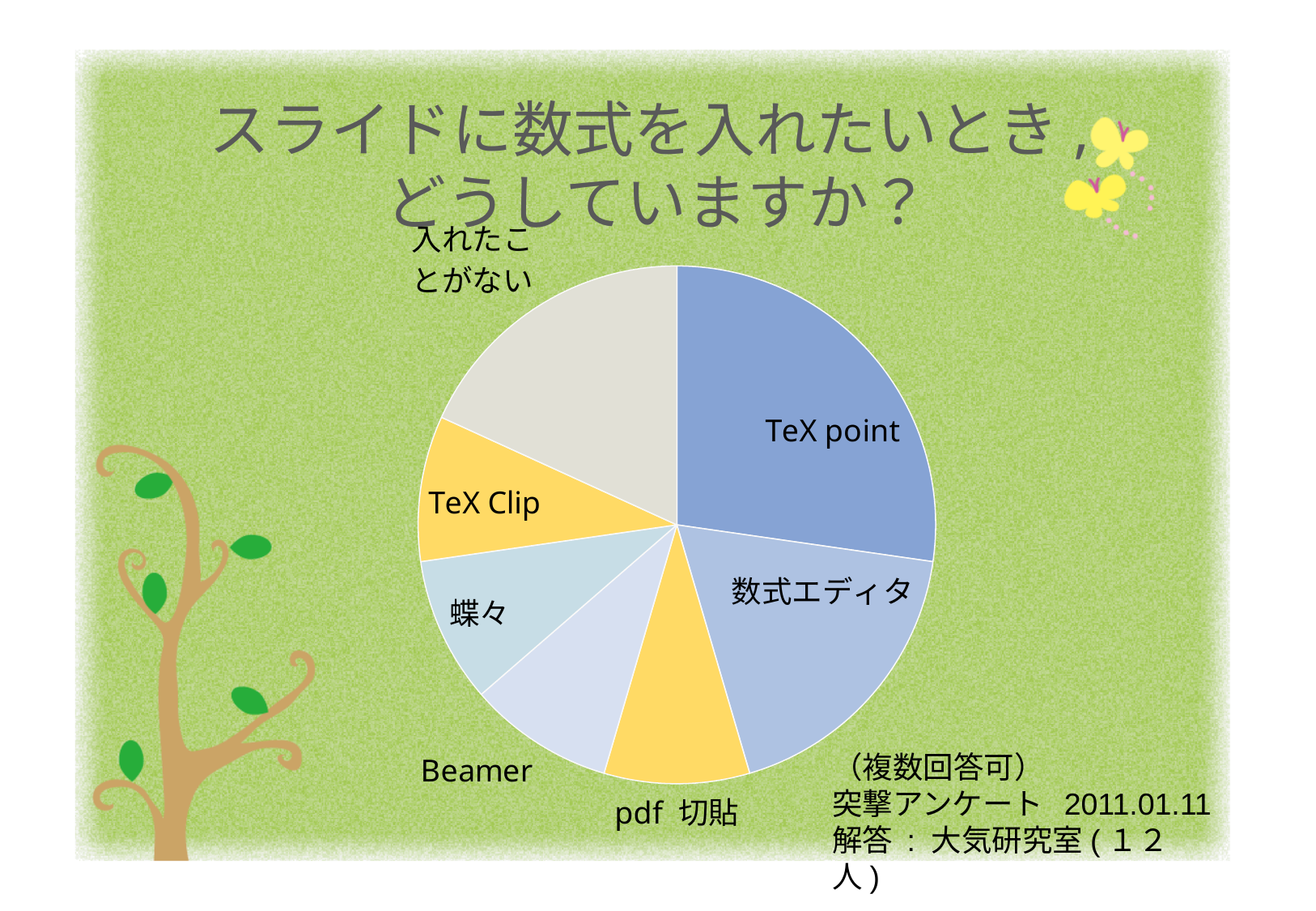
How many slices does the pie chart have? 7 Which category has the largest slice of the pie chart? TeX point Which slice is larger, TeX point or Beamer? TeX point Which slice is larger, TeX Clip or TeX point? TeX point What is the title of the slide containing the pie chart? スライドに数式を入れたいとき，どうしていますか？ What colour is the TeX point slice of the pie chart? blue Which slice is larger, 入れたことがない or pdf 切貼? 入れたことがない What kind of chart is shown on the slide? pie chart